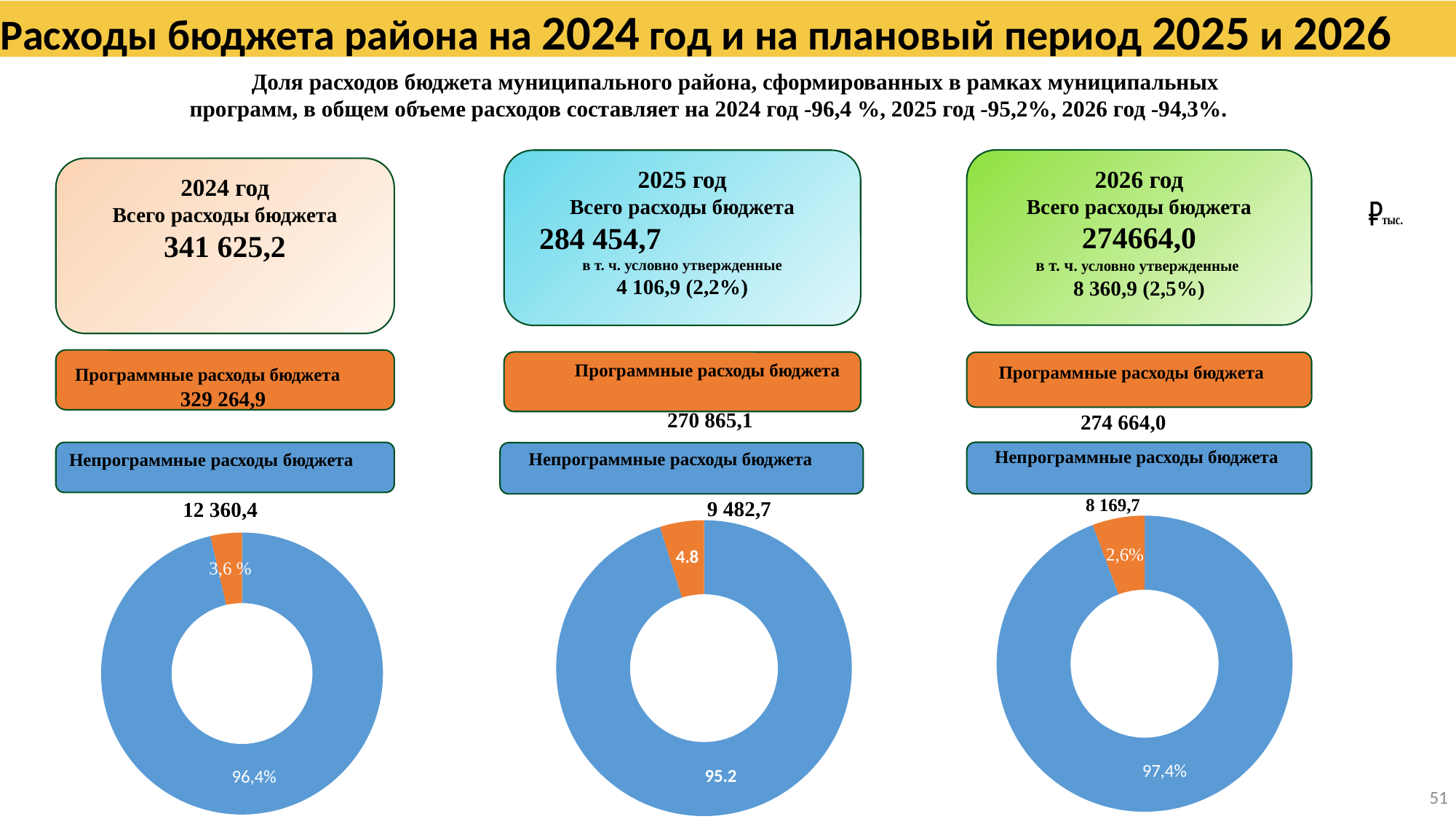
In the 2024 год doughnut chart, which slice is larger, the blue one or the orange one? The blue one How many slices does each doughnut chart on the slide contain? 2 In the 2024 год doughnut chart, what share is shown for the large blue slice? 96,4% In the 2026 год doughnut chart, what share is shown for the blue slice? 97,4% What kind of chart is used for the 2024 год chart at the bottom left of the slide? Doughnut (pie) chart In the 2025 год doughnut chart, what value is printed on the blue slice? 95.2 How many doughnut charts are shown on the slide? 3